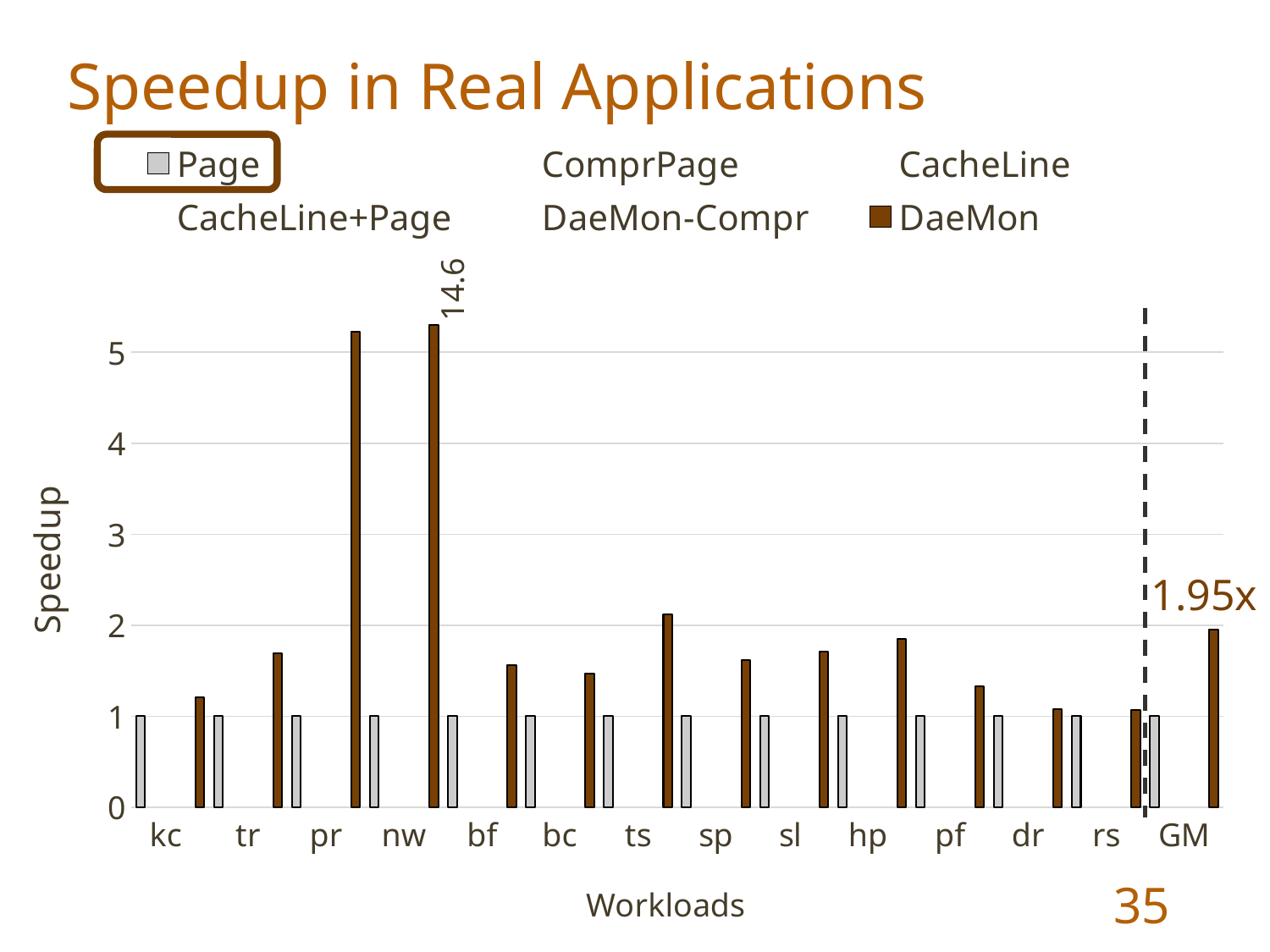
Is the DaeMon value for tr greater or less than 2? less What is the title of the chart? Speedup in Real Applications What is the DaeMon speedup value labeled for the nw workload? 14.6 What kind of chart is shown on the slide? bar chart Which workload has the highest DaeMon speedup? nw What is the label of the x axis? Workloads Is the DaeMon value for hp greater or less than 1? greater How many workload categories are shown on the x axis? 14 How many series does the legend list? 6 Which is larger, the DaeMon value for hp or the DaeMon value for pf? hp What is the DaeMon speedup value labeled for GM? 1.95x What is the Page speedup value for the kc workload? 1